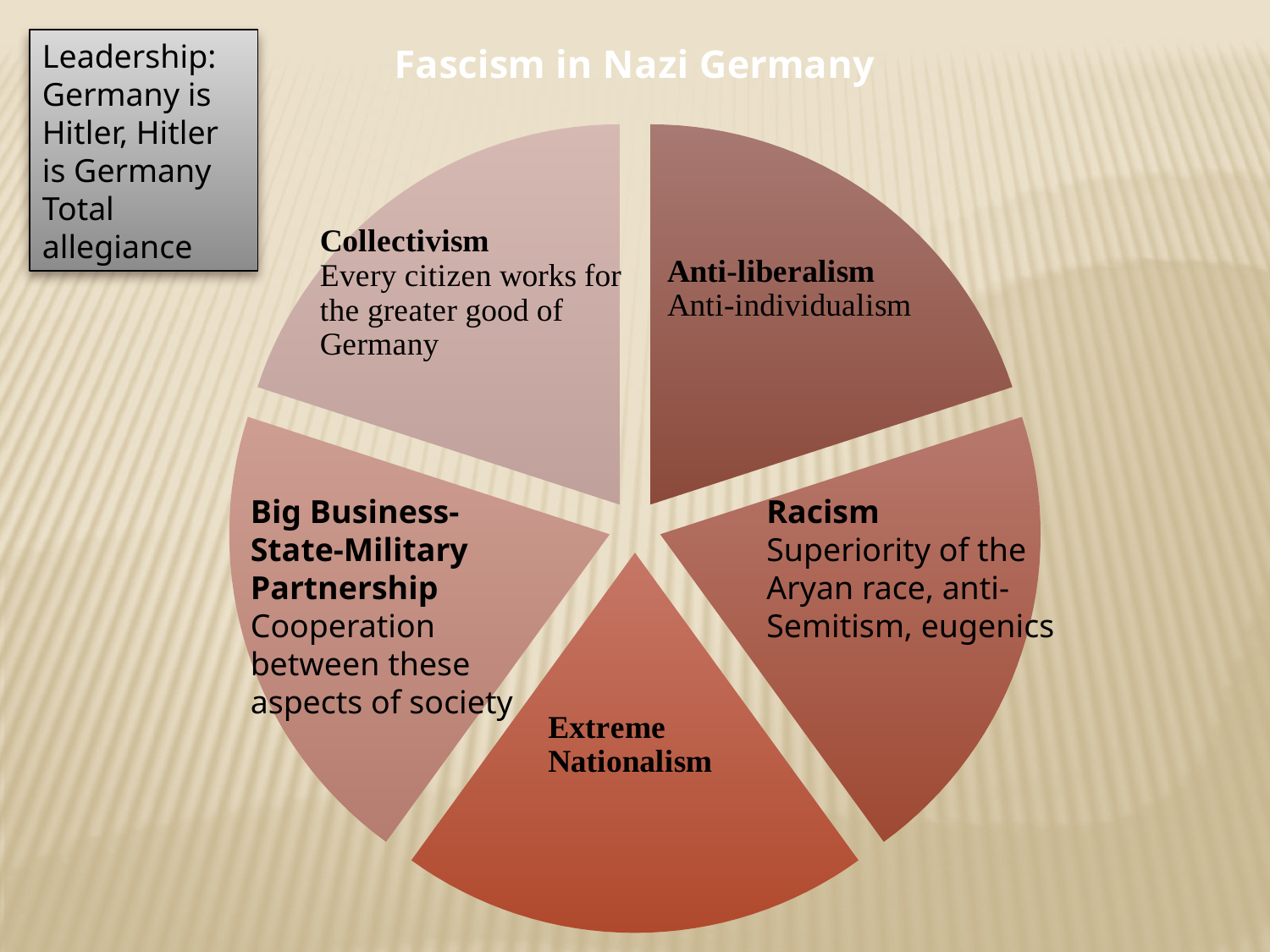
Which slice of the pie chart is described as "Superiority of the Aryan race, anti-Semitism, eugenics"? Racism Which slice of the pie chart is described as "Cooperation between these aspects of society"? Big Business-State-Military Partnership What is the title of the chart? Fascism in Nazi Germany What kind of chart is shown on the slide? Pie chart How many slices does the pie chart have? 5 Which slice of the pie chart is described as "Every citizen works for the greater good of Germany"? Collectivism Which slice of the pie chart is labelled with the description "Anti-individualism"? Anti-liberalism Which slice of the pie chart is at the bottom of the pie? Extreme Nationalism